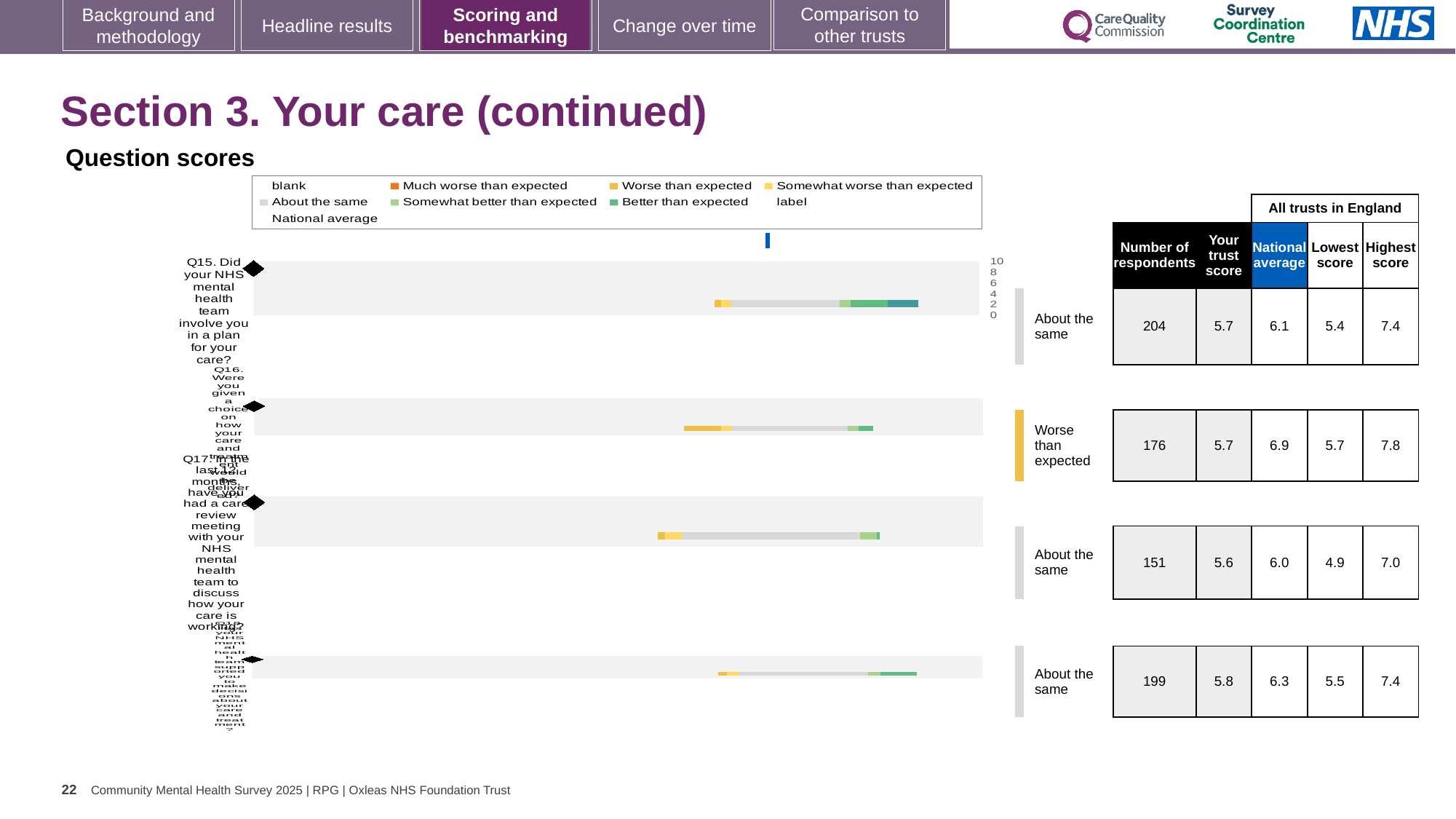
What kind of chart is used to show the question scores on this slide? bar chart How many question bars are plotted in the question scores chart? 4 Which is larger for Q15: the trust score or the national average? national average In the table beside the chart, what is the highest score among all trusts in England for Q16? 7.8 In the table beside the chart, what is the national average for Q17 (In the last 12 months, have you had a care review meeting)? 6.0 What benchmark category label is shown next to the Q16 bar? Worse than expected In the table beside the chart, what is the trust score for Q16 (Were you given a choice on how your care and treatment would be delivered)? 5.7 What is the lowest score among all trusts in England for Q17? 4.9 Which question row has the lowest number of respondents in the table beside the chart? Q17 How many entries does the legend of the question scores chart list? 9 What is the difference between the national average and the trust score for Q16? 1.2 In the table beside the chart, what is the number of respondents for Q15 (Did your NHS mental health team involve you in a plan for your care?)? 204